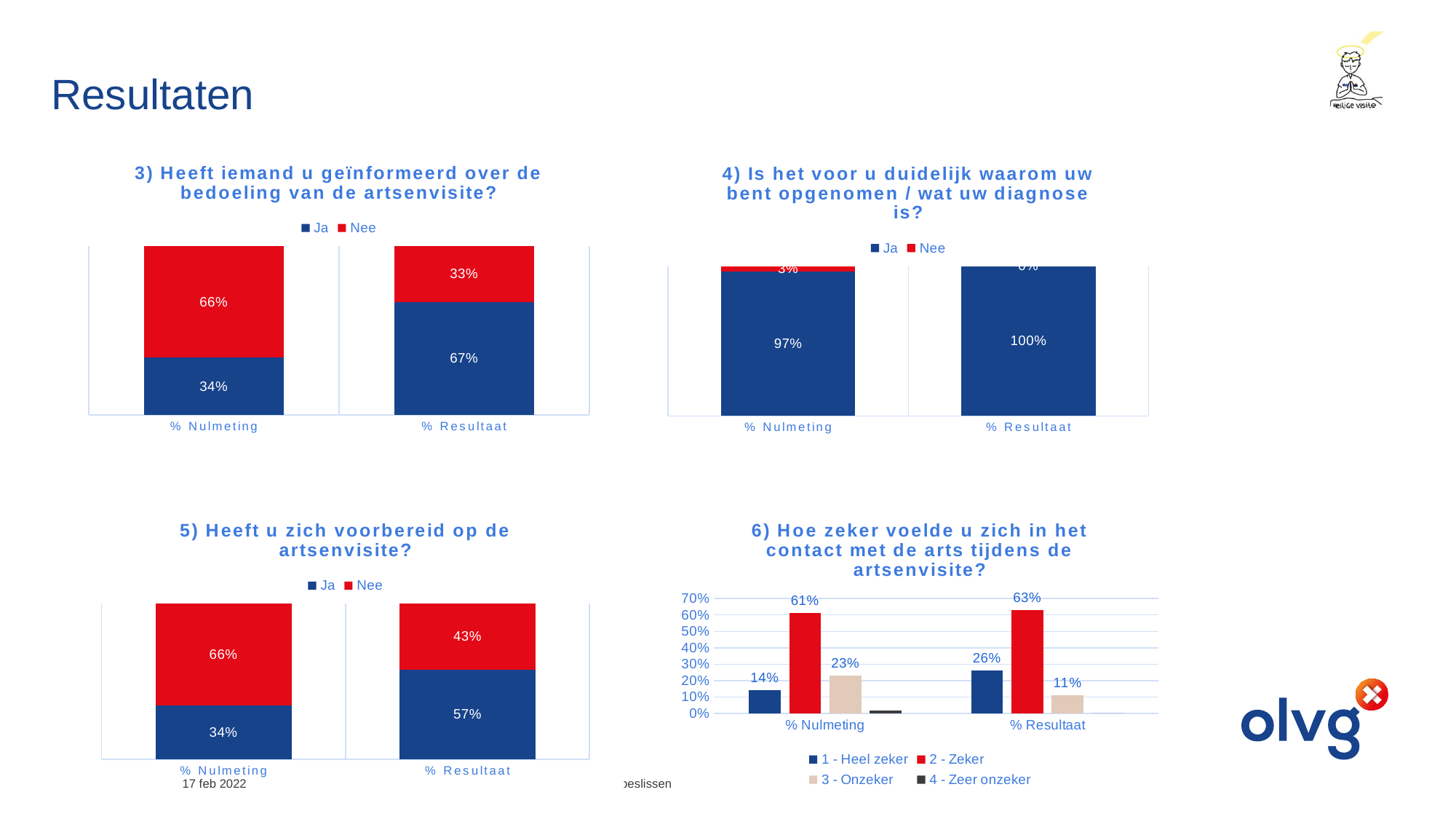
In the chart titled '5) Heeft u zich voorbereid op de artsenvisite?', what is the value for Nee in % Resultaat? 43% What kind of chart is the one titled '3) Heeft iemand u geïnformeerd over de bedoeling van de artsenvisite?'? Stacked bar chart In the chart titled '4) Is het voor u duidelijk waarom uw bent opgenomen / wat uw diagnose is?', what is the value for Ja in % Resultaat? 100% In the chart titled '6) Hoe zeker voelde u zich in het contact met de arts tijdens de artsenvisite?', what is the value for '2 - Zeker' in % Resultaat? 63% In the chart titled '6) Hoe zeker voelde u zich in het contact met de arts tijdens de artsenvisite?', how many series does the legend list? 4 In the chart titled '3) Heeft iemand u geïnformeerd over de bedoeling van de artsenvisite?', what is the value for Ja in % Resultaat? 67% In the chart titled '6) Hoe zeker voelde u zich in het contact met de arts tijdens de artsenvisite?', is the value for '3 - Onzeker' in % Nulmeting greater or less than 20%? greater In the chart titled '6) Hoe zeker voelde u zich in het contact met de arts tijdens de artsenvisite?', which is larger: '1 - Heel zeker' in % Nulmeting or '1 - Heel zeker' in % Resultaat? % Resultaat In the chart titled '3) Heeft iemand u geïnformeerd over de bedoeling van de artsenvisite?', what is the value for Nee in % Nulmeting? 66% In the chart titled '6) Hoe zeker voelde u zich in het contact met de arts tijdens de artsenvisite?', which series has the highest value in % Nulmeting? 2 - Zeker In the chart titled '5) Heeft u zich voorbereid op de artsenvisite?', what is the difference between the Ja values for % Resultaat and % Nulmeting? 23% In the chart titled '4) Is het voor u duidelijk waarom uw bent opgenomen / wat uw diagnose is?', what is the value for Ja in % Nulmeting? 97%